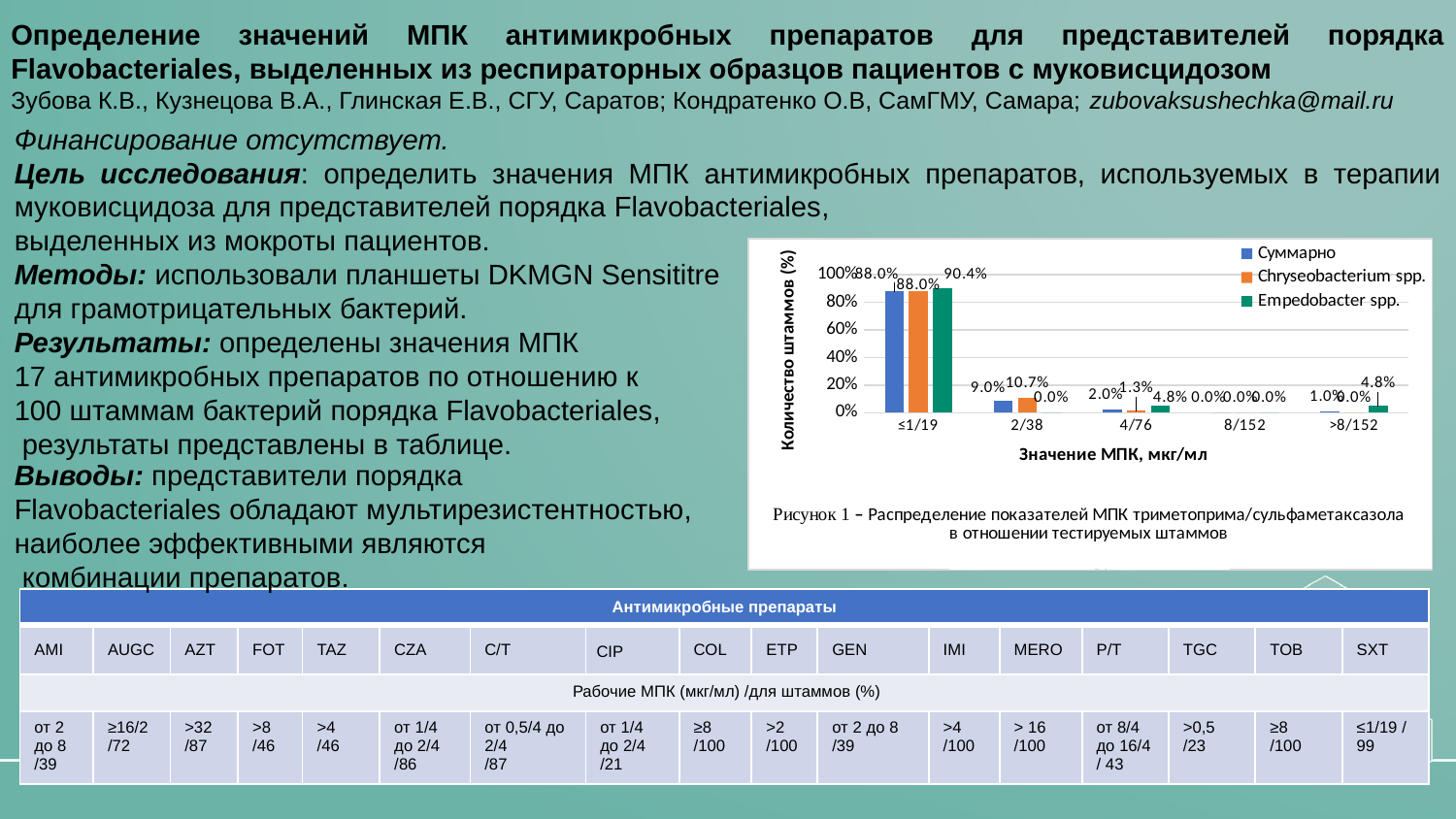
Which is larger at the 2/38 MIC category: the value for Chryseobacterium spp. or the value for Empedobacter spp.? Chryseobacterium spp. What is the value for Empedobacter spp. at the >8/152 MIC category? 4.8% What is the value for Empedobacter spp. at the ≤1/19 MIC category? 90.4% How many MIC categories are shown on the x axis of the chart? 5 What is the label of the y axis of the chart? Количество штаммов (%) Which MIC category has the highest value for the Суммарно series? ≤1/19 What is the value for Суммарно at the 2/38 MIC category? 9.0% What is the label of the x axis of the chart? Значение МПК, мкг/мл What kind of chart is shown on the slide? bar chart What is the value for Chryseobacterium spp. at the 2/38 MIC category? 10.7% What is the difference between the Empedobacter spp. value and the Суммарно value at the ≤1/19 MIC category? 2.4% How many series does the chart legend list? 3